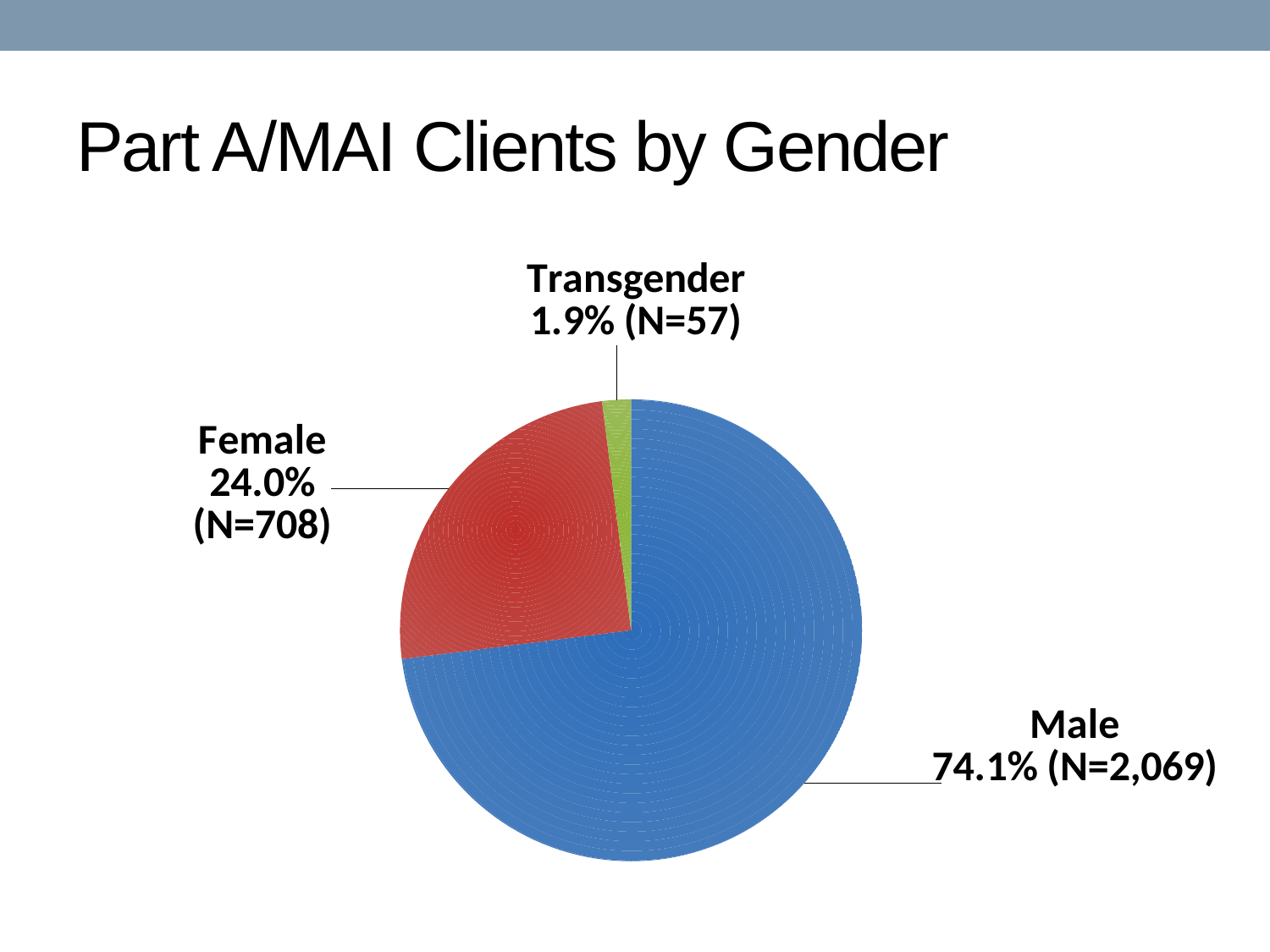
How many more Female clients are there than Transgender clients? 651 What percentage of clients are Transgender? 1.9% Which gender category has the largest share of clients? Male Which gender category has the smallest share of clients? Transgender What is the number of Female clients (N) shown on the chart? 708 What is the title of the slide? Part A/MAI Clients by Gender What percentage of Part A/MAI clients are Male? 74.1% Which is larger, the Female share or the Transgender share? Female What is the difference in percentage points between the Male and Female shares? 50.1 What is the number of Male clients (N) shown on the chart? 2,069 What type of chart is shown on the slide? Pie chart How many gender categories are shown in the pie chart? 3